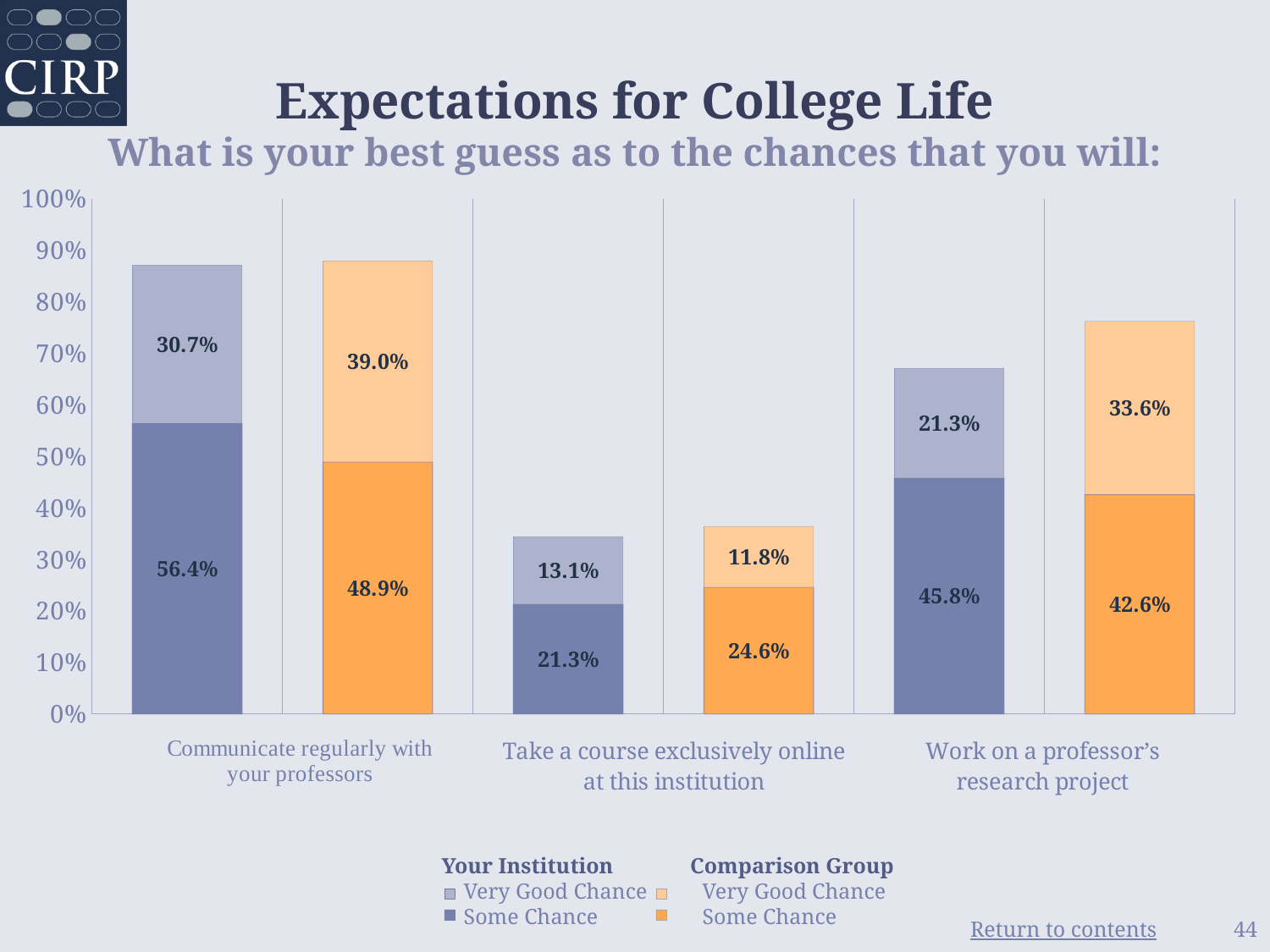
What kind of chart is shown on the slide? Stacked bar chart Which is larger for 'Communicate regularly with your professors': the Some Chance value for Your Institution or for the Comparison Group? Your Institution Which category has the highest Some Chance value for the Comparison Group? Communicate regularly with your professors What percentage of the Comparison Group said there is Some Chance they will take a course exclusively online at this institution? 24.6% What percentage of the Comparison Group said there is a Very Good Chance they will work on a professor's research project? 33.6% Which category has the lowest Very Good Chance value for Your Institution? Take a course exclusively online at this institution What is the total percentage (Some Chance plus Very Good Chance) for Your Institution for 'Work on a professor's research project'? 67.1% How many series does the legend list? 4 How many categories are shown on the x axis of the chart? 3 What percentage of Your Institution students said there is a Very Good Chance they will communicate regularly with their professors? 30.7% What is the difference between the Comparison Group's and Your Institution's Very Good Chance values for 'Work on a professor's research project'? 12.3% What is the total percentage (Some Chance plus Very Good Chance) for the Comparison Group for 'Take a course exclusively online at this institution'? 36.4%